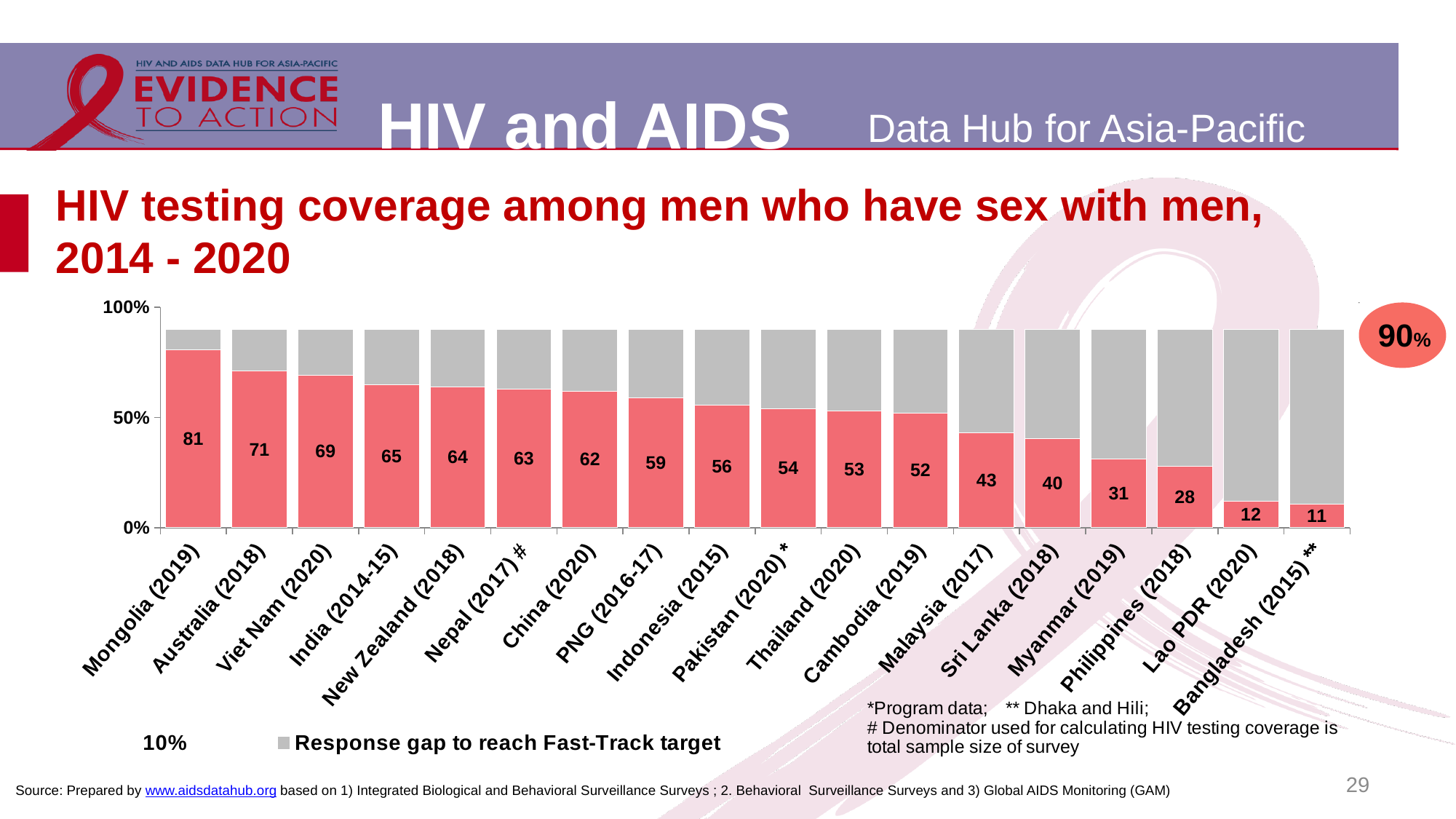
What kind of chart is shown on the slide? bar chart Which country has the highest HIV testing coverage value in the chart? Mongolia (2019) What is the value shown for Thailand (2020)? 53 Is the value for Philippines (2018) greater or less than 50%? less Which has a larger value, Viet Nam (2020) or Malaysia (2017)? Viet Nam (2020) What is the value shown for Myanmar (2019)? 31 How many countries are shown on the x axis of the chart? 18 What is the HIV testing coverage value shown for Mongolia (2019)? 81 Which country has the lowest HIV testing coverage value in the chart? Bangladesh (2015) ** What does the grey portion of each bar represent, according to the legend? Response gap to reach Fast-Track target Do the red bar values rise or fall from left to right along the x axis? fall What is the difference between the values for Australia (2018) and Sri Lanka (2018)? 31